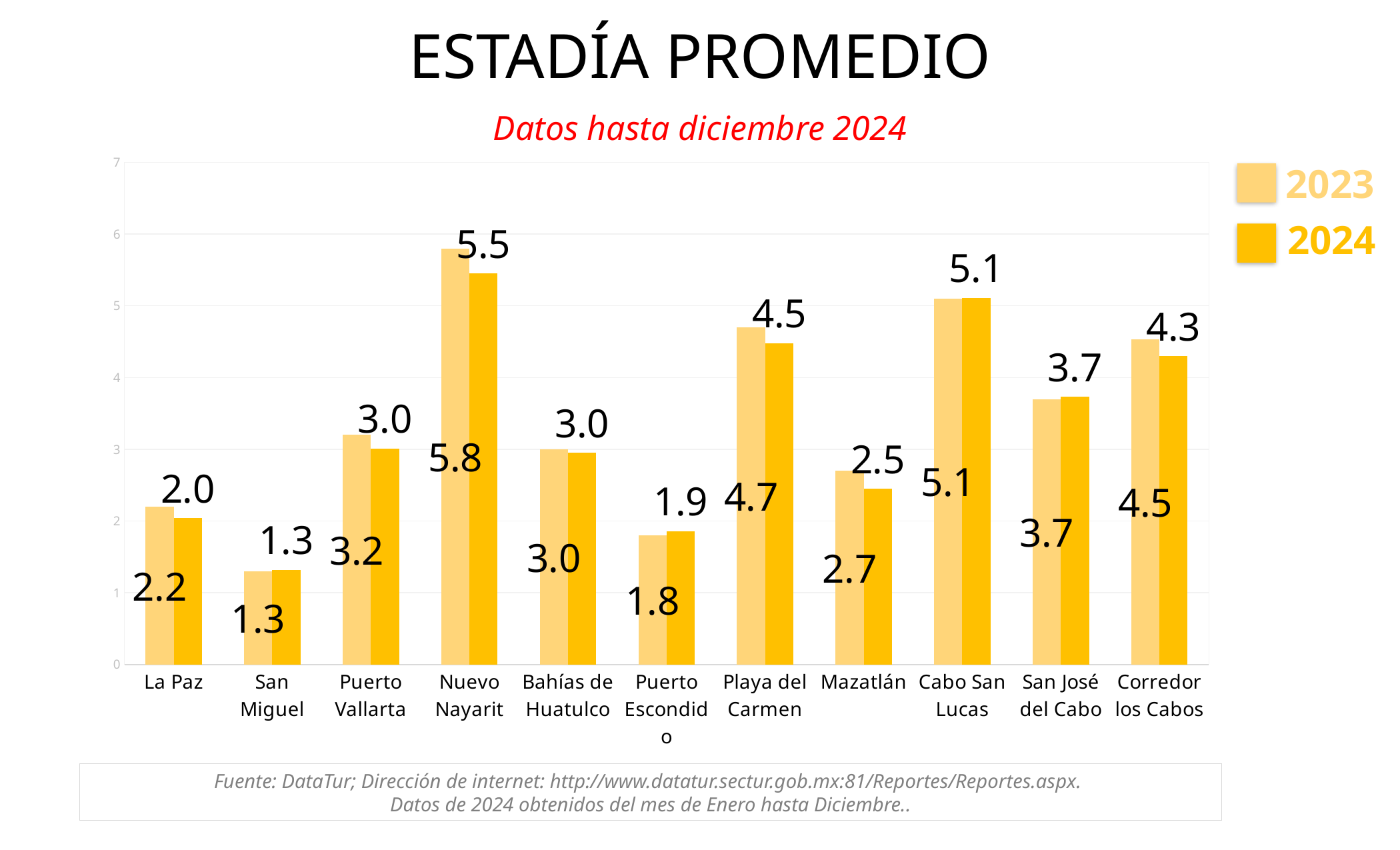
Which is larger for Mazatlán, the 2023 value or the 2024 value? 2023 What is the 2023 value for Playa del Carmen? 4.7 What is the 2024 value for Nuevo Nayarit? 5.5 What is the 2024 value for Puerto Escondido? 1.9 How many series does the legend list? 2 What type of chart is shown on the slide? bar chart Is the 2024 value for Cabo San Lucas greater or less than 4? greater What is the subtitle shown in red below the chart title? Datos hasta diciembre 2024 Which destination has the lowest 2024 value? San Miguel Which destination has the highest 2023 value? Nuevo Nayarit What is the difference between the 2023 and 2024 values for Corredor los Cabos? 0.2 How many destinations are shown on the x axis? 11